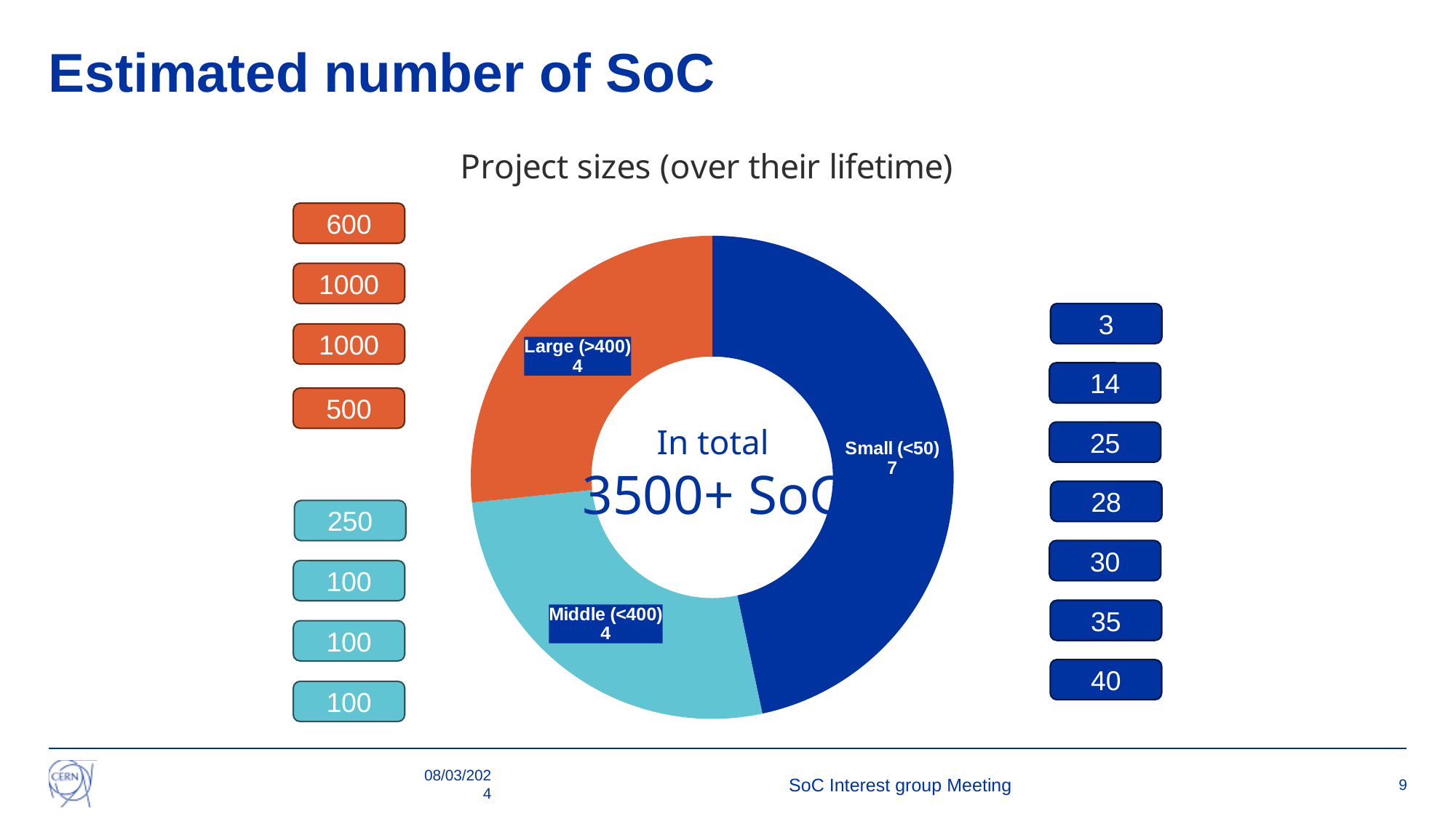
What kind of chart is shown on the slide? pie chart (doughnut) What is the value shown for the Small (<50) slice? 7 Which is larger, the value for Small (<50) or the value for Middle (<400)? Small (<50) Which two categories in the chart have the same value? Middle (<400) and Large (>400) How many categories (slices) does the chart have? 3 What is the sum of the values of all three slices in the chart? 15 What text is written in the centre of the doughnut chart? In total 3500+ SoC What is the title of the chart? Project sizes (over their lifetime) What is the difference between the value for Small (<50) and the value for Large (>400)? 3 Which category has the highest value in the chart? Small (<50) What is the value shown for the Large (>400) slice? 4 What is the value shown for the Middle (<400) slice? 4